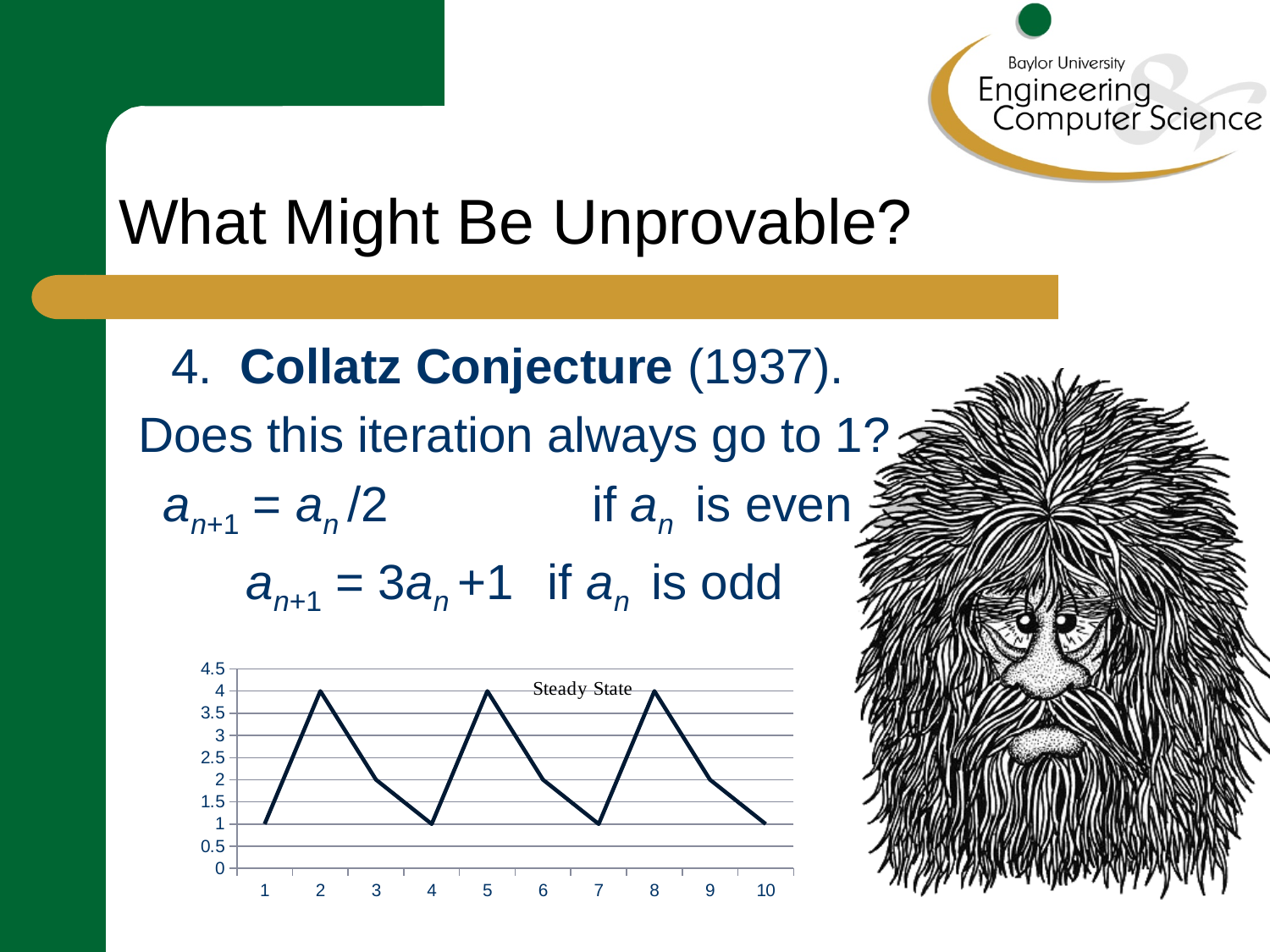
How many points are plotted along the x axis of the chart? 10 Which is larger, the value at x = 5 or the value at x = 6? x = 5 What is the highest value reached by the line? 4 What is the lowest value reached by the line? 1 Does the line rise or fall from x = 2 to x = 4? fall What is the value of the line at x = 2? 4 What kind of chart is shown on the slide? line chart What is the value of the line at x = 3? 2 What text label is printed inside the chart area? Steady State What is the difference between the value at x = 2 and the value at x = 3? 2 Is the value at x = 8 greater or less than 3? greater What is the value of the line at x = 4? 1